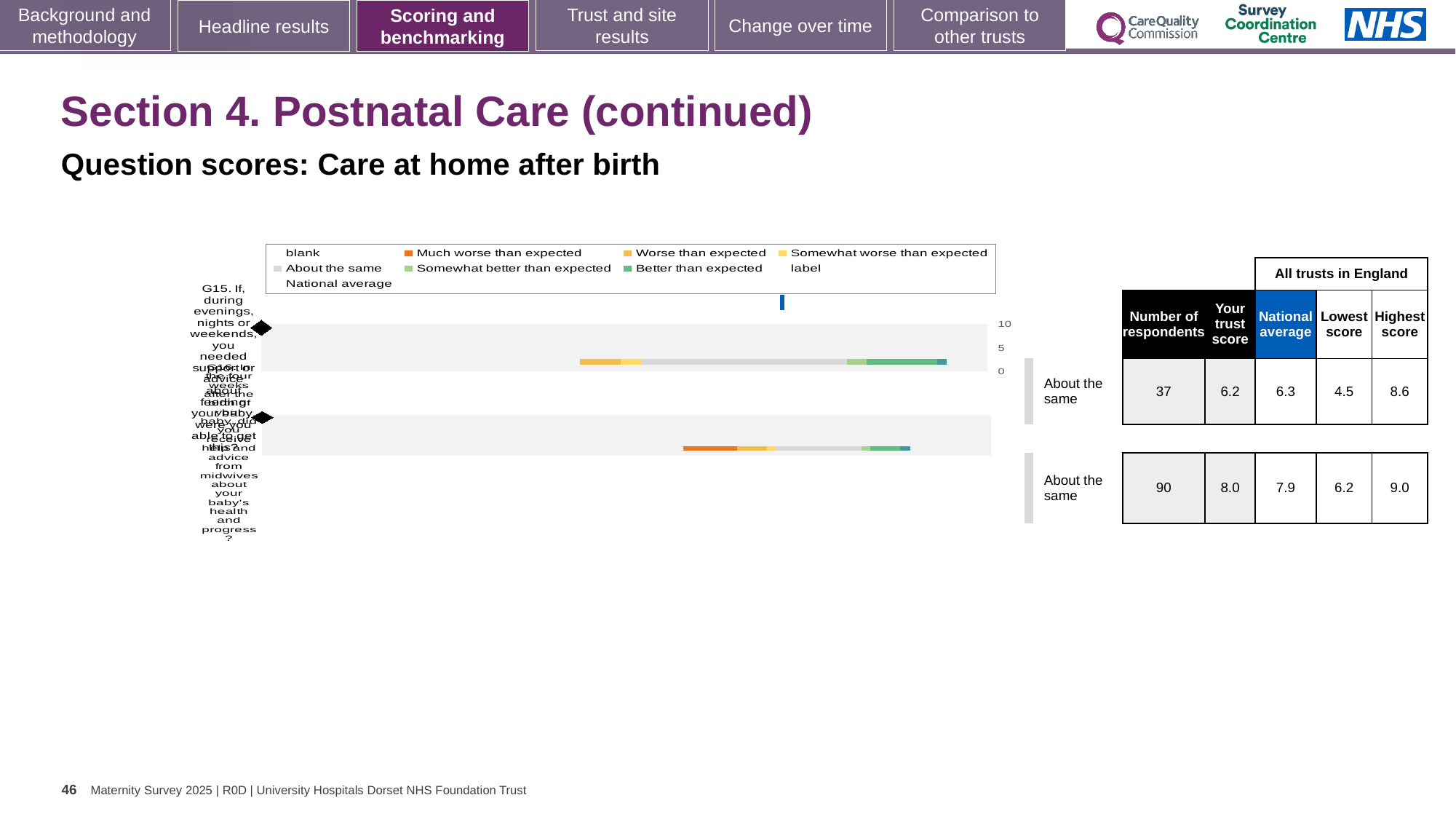
In the legend, what colour represents 'Much worse than expected'? orange How many bars (question rows) does the chart show? 2 What is the difference between the highest score and the lowest score for the first row? 4.1 What kind of chart is shown on the slide? bar chart In the table beside the chart, what is the highest score for the second row? 9.0 In the table beside the chart, what is the number of respondents for the first row? 37 What is the highest tick value shown on the chart's axis? 10 Which row has the higher 'Your trust score', the first row or the second row? second row What benchmark label is shown next to both bars? About the same In the table beside the chart, what is the national average for the second row? 7.9 In the table beside the chart, what is 'Your trust score' for the first row? 6.2 In the table beside the chart, what is the lowest score for the first row? 4.5